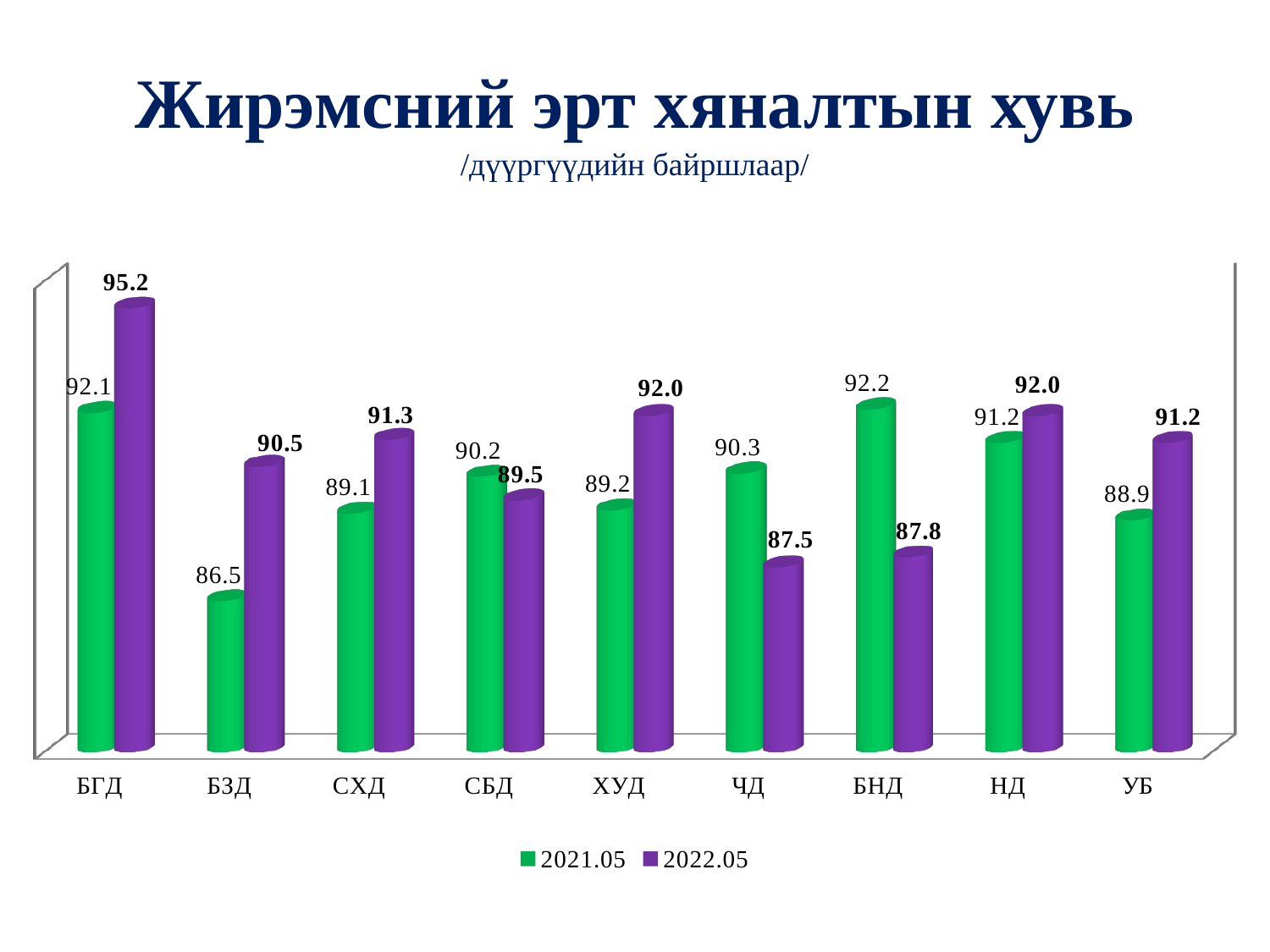
What is the value for БГД in the 2022.05 series? 95.2 For ЧД, which series has the larger value, 2021.05 or 2022.05? 2021.05 How many categories are shown on the x axis? 9 What is the difference between the 2022.05 and 2021.05 values for БЗД? 4.0 What is the value for БЗД in the 2021.05 series? 86.5 Which category has the lowest value in the 2021.05 series? БЗД Which category has the highest value in the 2022.05 series? БГД How many series does the legend list? 2 What is the value for УБ in the 2021.05 series? 88.9 What is the value for ЧД in the 2022.05 series? 87.5 What is the difference between the 2022.05 and 2021.05 values for БГД? 3.1 What kind of chart is shown on the slide? Bar chart